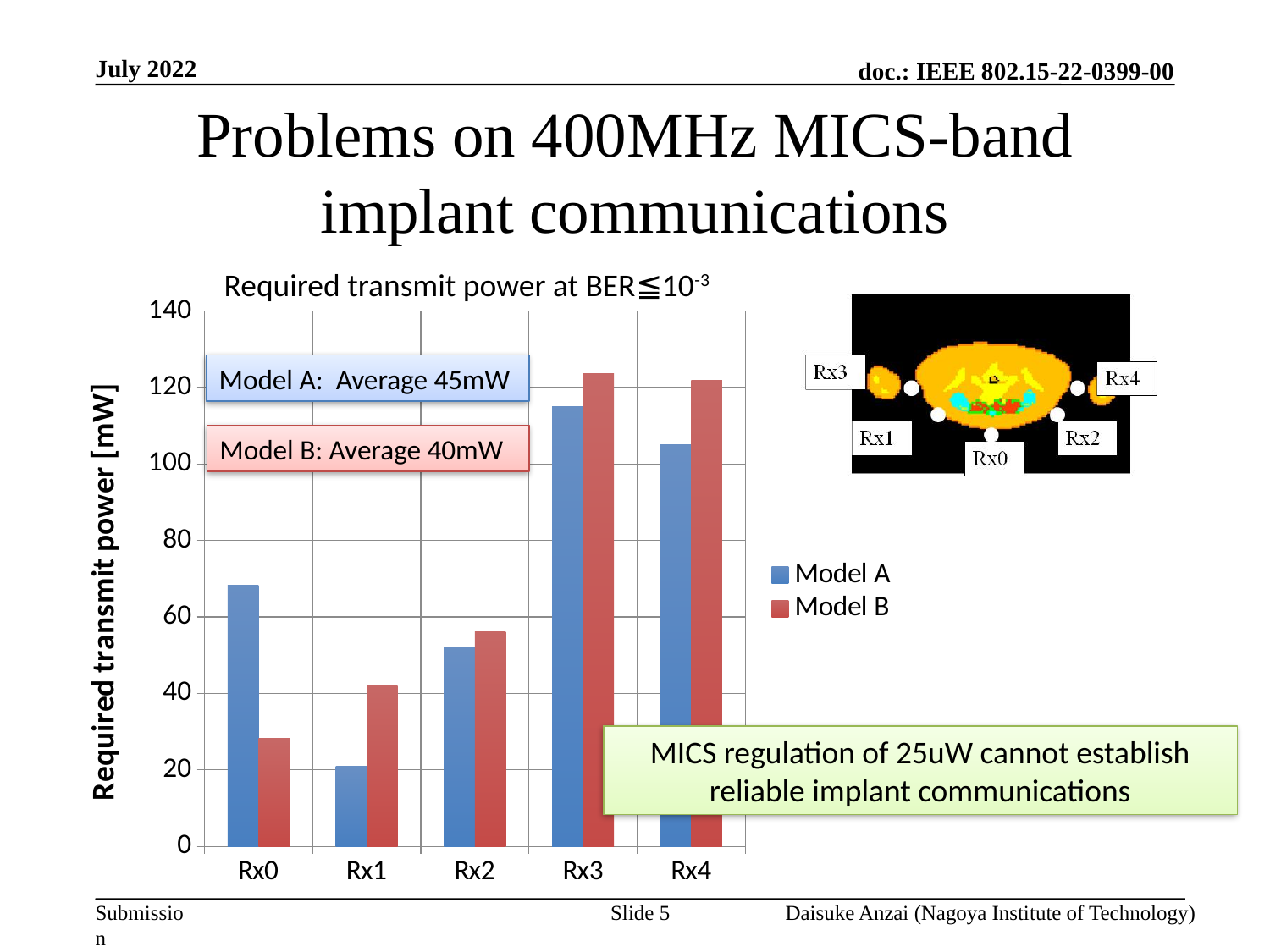
What is the label of the chart's vertical axis? Required transmit power [mW] At Rx0, which model requires more transmit power, Model A or Model B? Model A Is the Model A value for Rx3 greater or less than 100? greater For Model B, which receiver has the lowest required transmit power? Rx0 For Model A, which receiver has the lowest required transmit power? Rx1 How many series does the chart legend list? 2 For Model A, which receiver has the highest required transmit power? Rx3 Is the Model B value for Rx4 greater or less than 100? greater How many receiver categories are shown on the x axis of the chart? 5 What kind of chart is shown on the slide? bar chart At Rx1, which model requires more transmit power, Model A or Model B? Model B Is the Model A value for Rx1 greater or less than 40? less